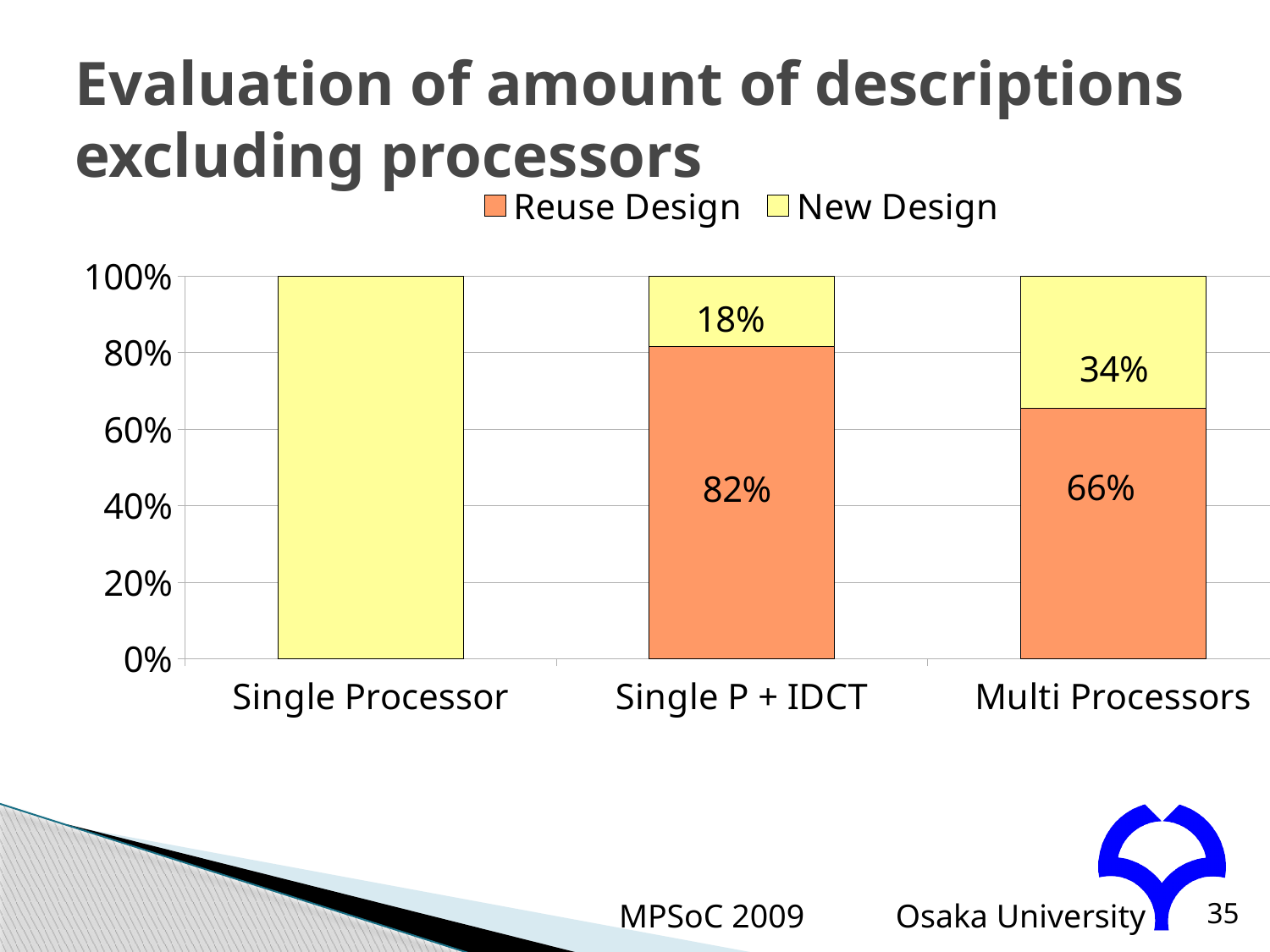
What is the difference between the Reuse Design values for Single P + IDCT and Multi Processors? 16 percentage points What is the Reuse Design value for Multi Processors? 66% What is the total of the stacked bar for Single P + IDCT? 100% Which category has the highest New Design share? Single Processor How many series does the legend list? 2 What kind of chart is shown on the slide? Stacked bar chart Is the New Design value for Single Processor greater or less than 80%? greater What is the Reuse Design value for Single P + IDCT? 82% What is the New Design value for Single P + IDCT? 18% What is the New Design value for Multi Processors? 34% How many categories are shown on the x axis? 3 Which has the larger Reuse Design value, Single P + IDCT or Multi Processors? Single P + IDCT